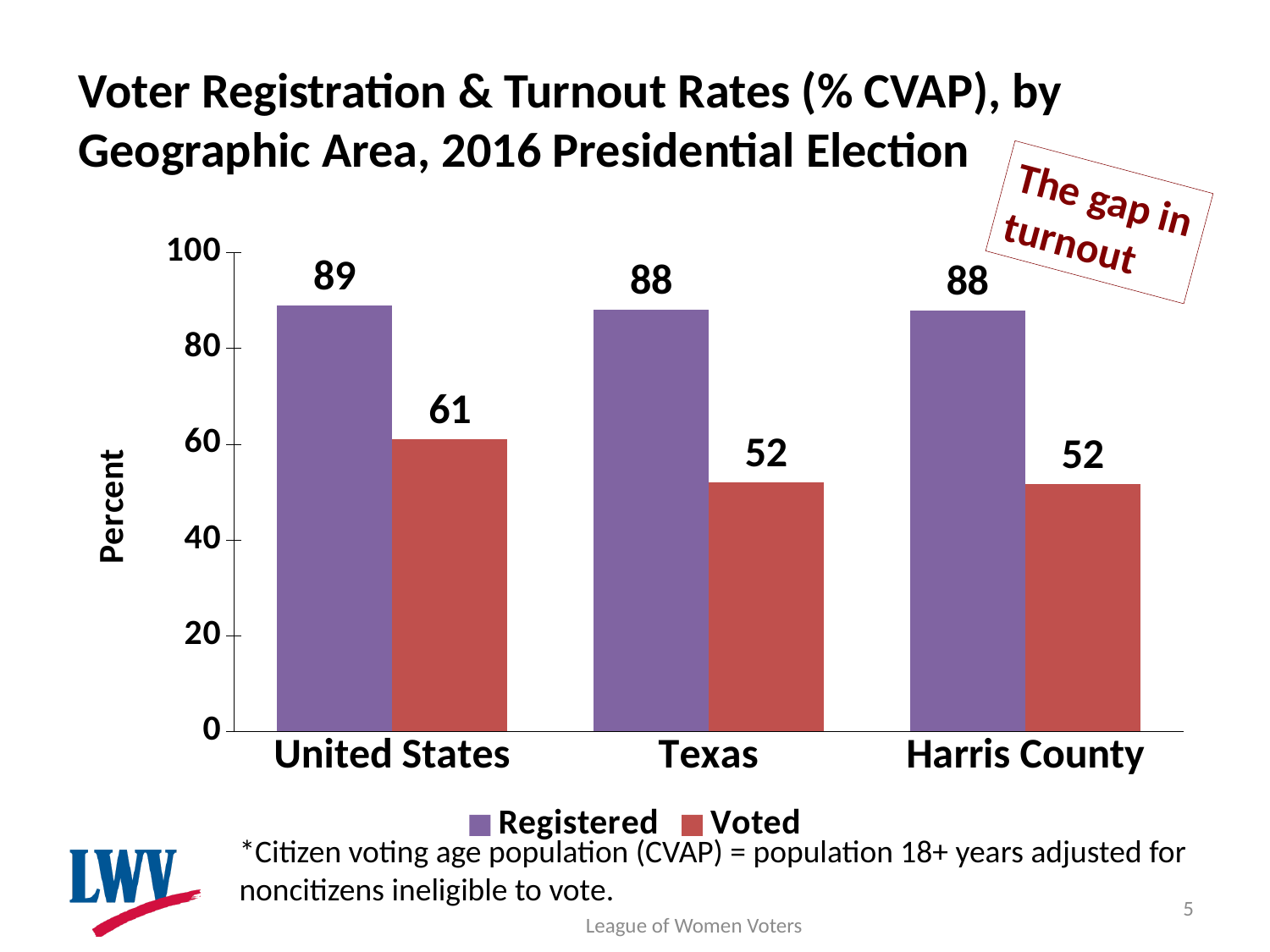
How many geographic areas are shown on the x axis? 3 What is the Voted value for Texas? 52 What is the label on the vertical axis? Percent What is the difference between the Registered and Voted values for the United States? 28 Which geographic area has the highest Voted value? United States Which is larger, the Voted value for the United States or the Voted value for Harris County? United States What kind of chart is shown on the slide? Bar chart How many series does the legend list? 2 What is the Registered value for the United States? 89 What is the Registered value for Harris County? 88 What is the Voted value for the United States? 61 What is the difference between the Registered and Voted values for Texas? 36